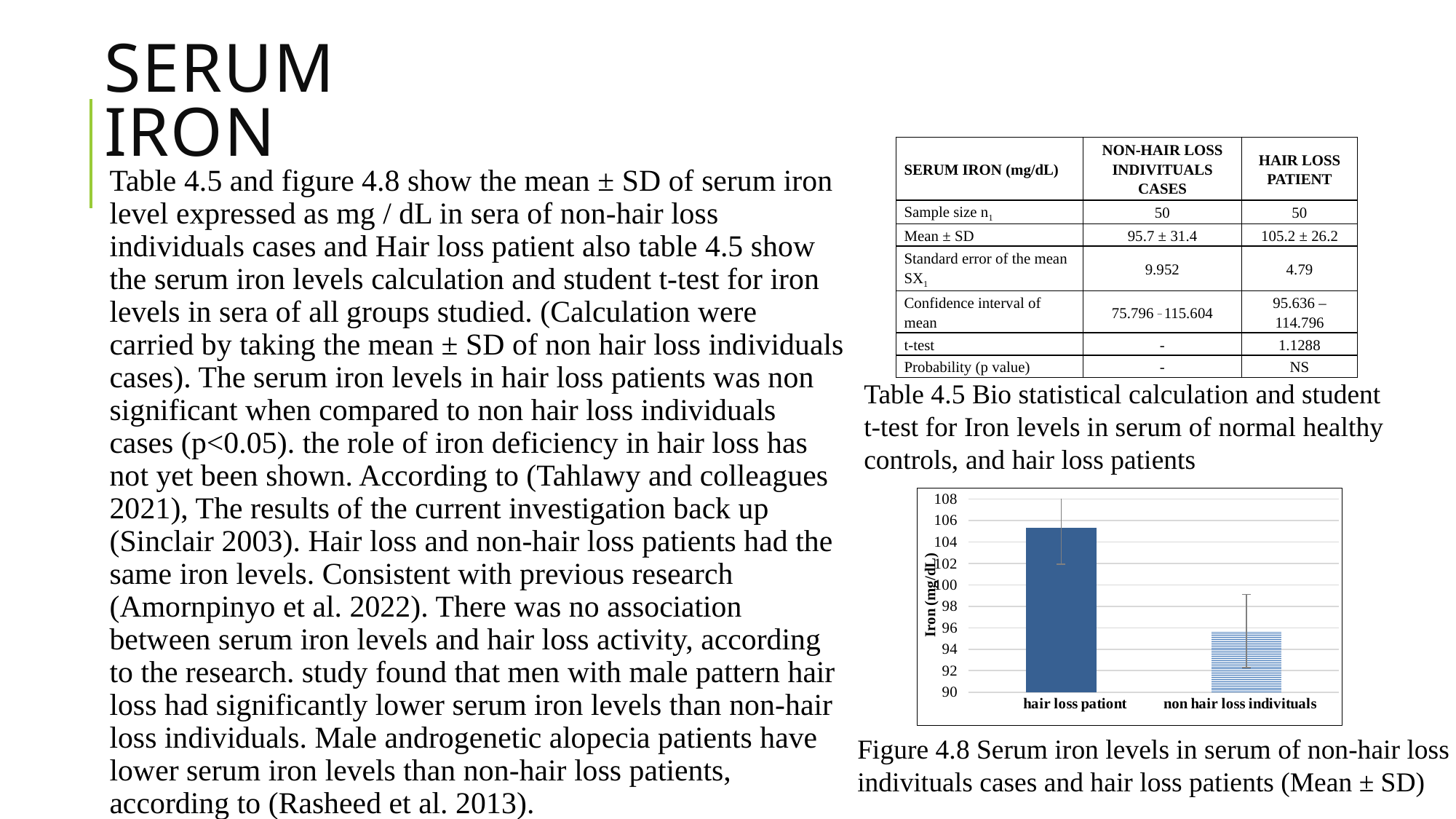
What is the lowest value shown on the y-axis of the Figure 4.8 chart? 90 In the Figure 4.8 chart, is the value for non hair loss individuals greater or less than 94? greater How many bars are plotted in the Figure 4.8 chart? 2 In the Figure 4.8 chart, which category has the lowest serum iron level? non hair loss individuals In the Figure 4.8 chart, is the value for hair loss pationt greater or less than 100? greater In the Figure 4.8 chart, is the value for non hair loss individuals greater or less than 100? less What kind of chart is shown in Figure 4.8? bar chart In the Figure 4.8 chart, which category has the highest serum iron level? hair loss pationt What is the y-axis label of the Figure 4.8 chart? Iron (mg/dL) In the Figure 4.8 chart, which bar is taller: hair loss pationt or non hair loss individuals? hair loss pationt In the Figure 4.8 chart, do the bar values rise or fall from left to right? fall